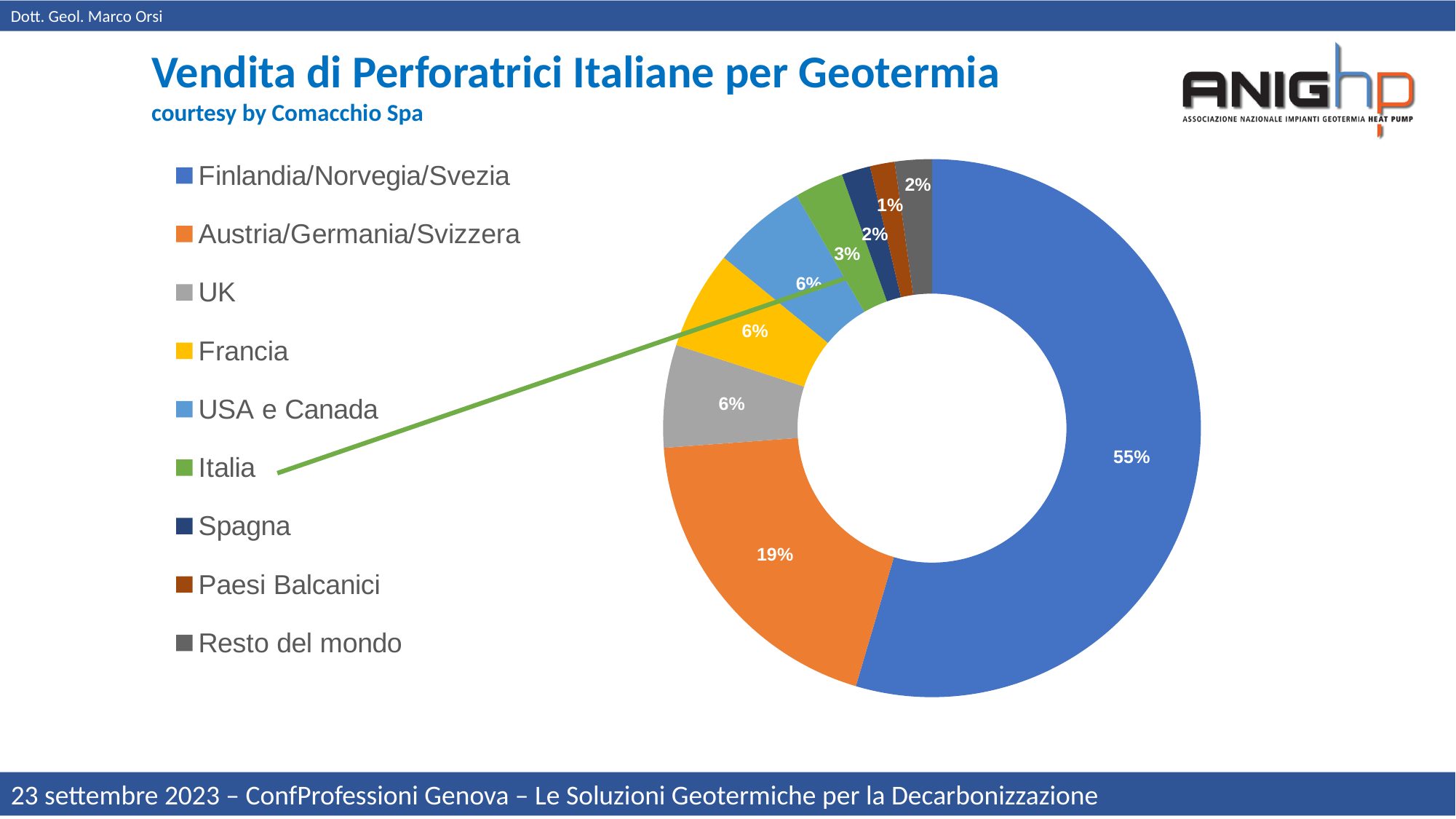
What share of sales does Finlandia/Norvegia/Svezia account for? 55% What share of sales does Austria/Germania/Svizzera account for? 19% What is the title of the chart on the slide? Vendita di Perforatrici Italiane per Geotermia What share of sales does Italia account for? 3% What is the combined share of UK, Francia and USA e Canada? 18% Which is larger, the share for Italia or the share for Spagna? Italia What share of sales does Paesi Balcanici account for? 1% How many categories are shown in the chart? 9 Which category has the smallest share of the chart? Paesi Balcanici What is the difference in percentage points between Finlandia/Norvegia/Svezia and Austria/Germania/Svizzera? 36 What kind of chart is shown on the slide? doughnut chart Which category has the largest share of the chart? Finlandia/Norvegia/Svezia